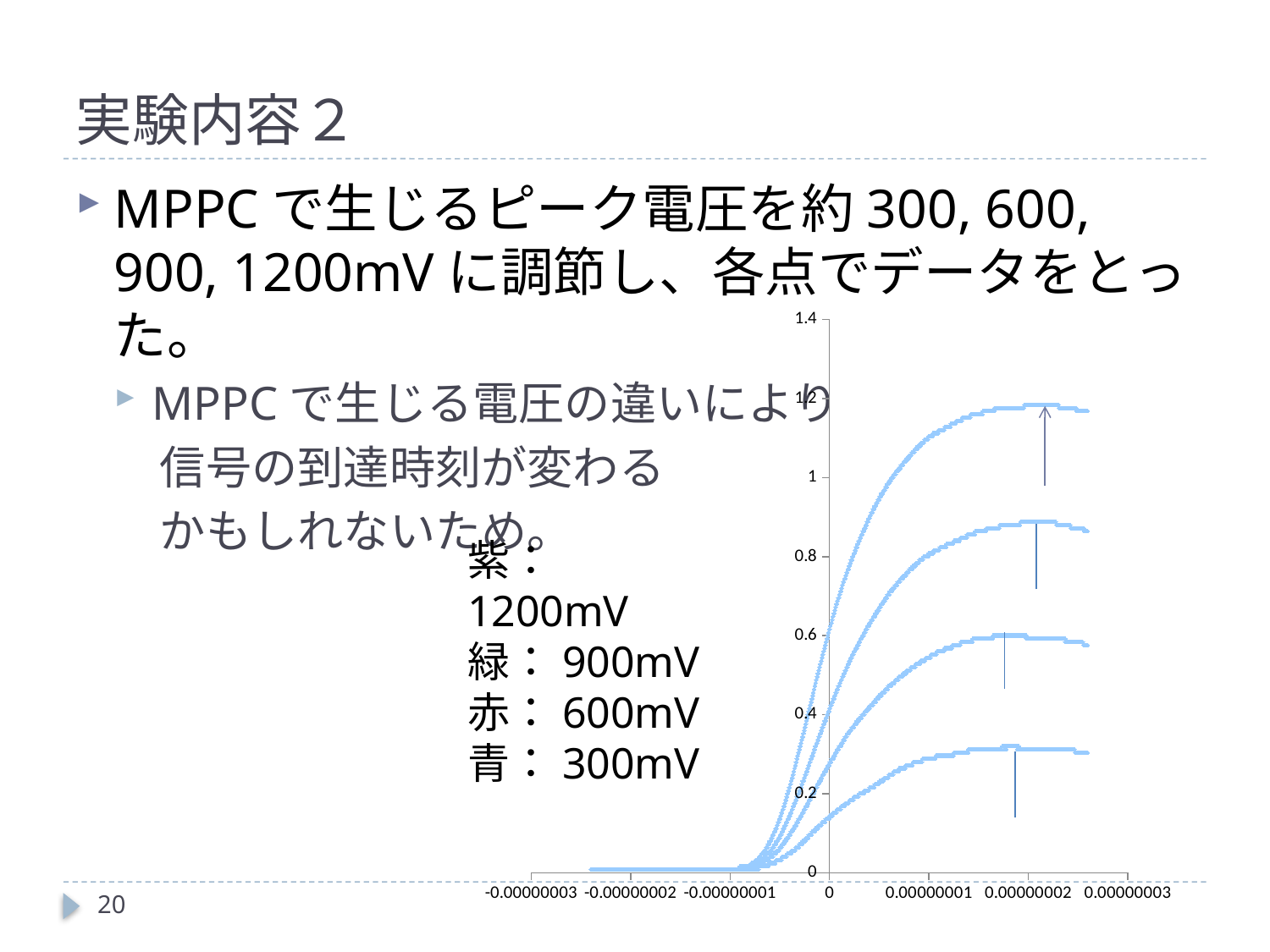
What is the leftmost tick value shown on the x axis? -0.00000003 Is the peak value of the lowest curve greater or less than 0.4? less How many curves are plotted on the chart? 4 What kind of chart is shown on the slide? line chart Is the peak value of the second-highest curve greater or less than 0.8? greater What is the highest tick value shown on the y axis? 1.4 Is the peak value of the lowest curve greater or less than 0.2? greater Do the curves rise or fall as the x value increases from -0.00000001 to 0.00000001? rise